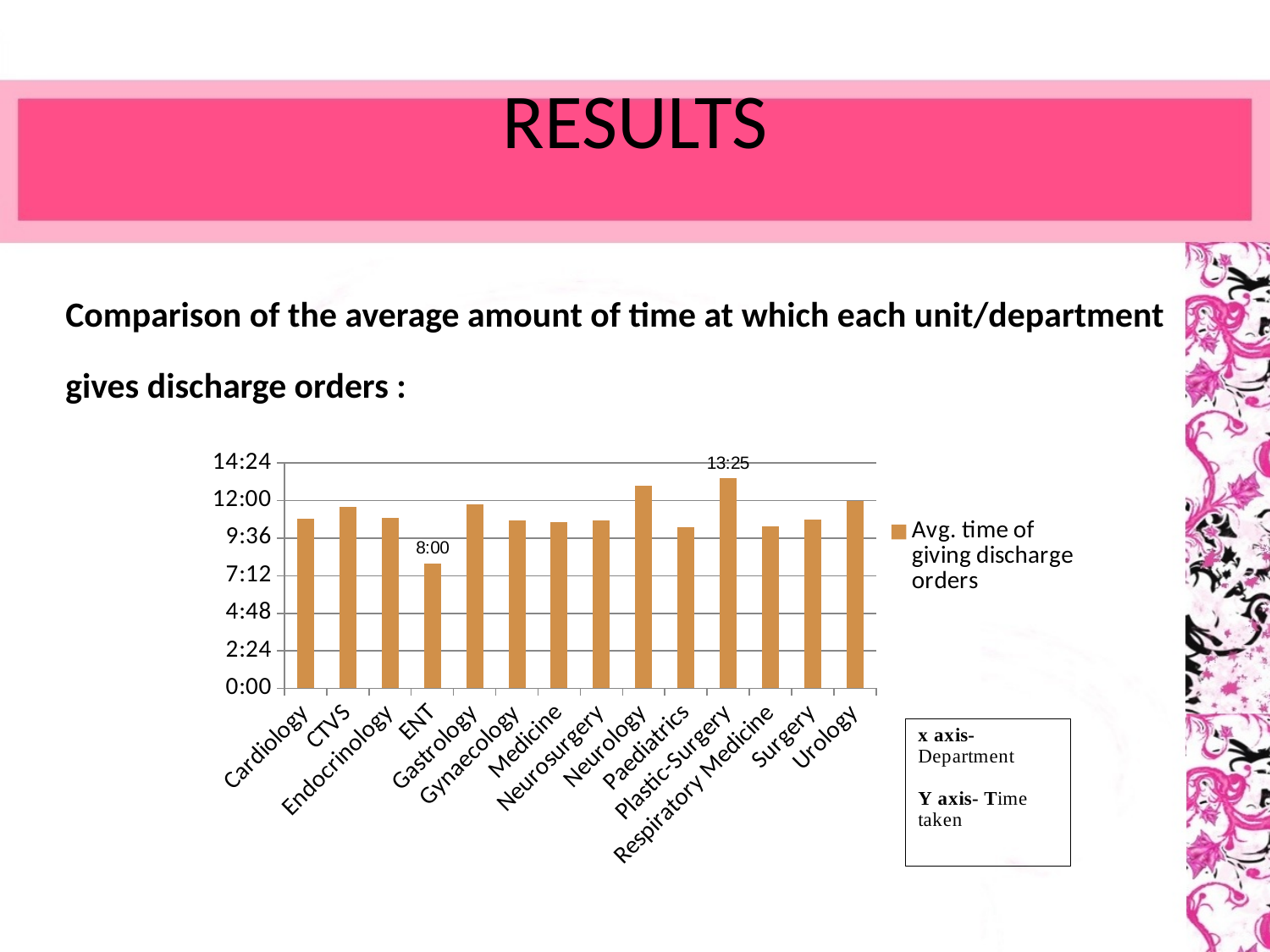
Is the value for Paediatrics greater or less than 12:00? less How many series does the chart legend list? 1 What is the difference between the average discharge order times of Plastic-Surgery and ENT? 5:25 Which department has the highest average time of giving discharge orders? Plastic-Surgery Is the value for Neurology greater or less than 12:00? greater What is the average time of giving discharge orders for Plastic-Surgery? 13:25 Which department has the lowest average time of giving discharge orders? ENT What is the average time of giving discharge orders for ENT? 8:00 Which department has a larger average discharge order time, Neurology or Paediatrics? Neurology How many departments are shown on the x axis of the chart? 14 Is the value for Cardiology greater or less than 9:36? greater What type of chart is shown on the slide? Bar chart